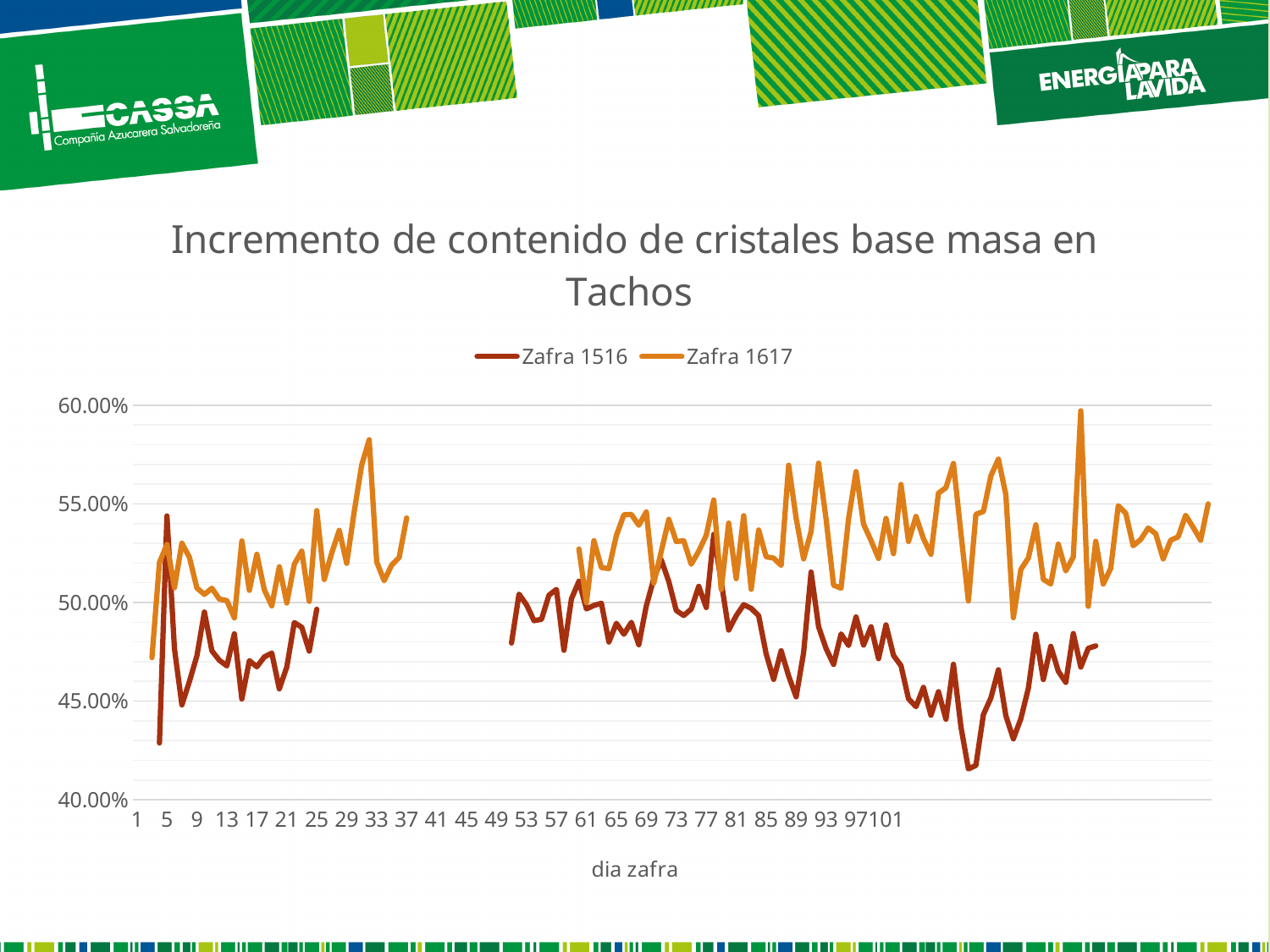
Which series generally has the higher values across the chart, Zafra 1516 or Zafra 1617? Zafra 1617 Which series is drawn in orange? Zafra 1617 What is the title of the chart? Incremento de contenido de cristales base masa en Tachos Is the lowest value reached by the Zafra 1516 series greater or less than 45.00%? less Is the highest value reached by the Zafra 1516 series greater or less than 55.00%? less How many series does the legend list? 2 Is the lowest value reached by the Zafra 1617 series greater or less than 45.00%? greater What kind of chart is shown on the slide? line chart Which series reaches the highest single value on the chart? Zafra 1617 What is the label of the x axis? dia zafra